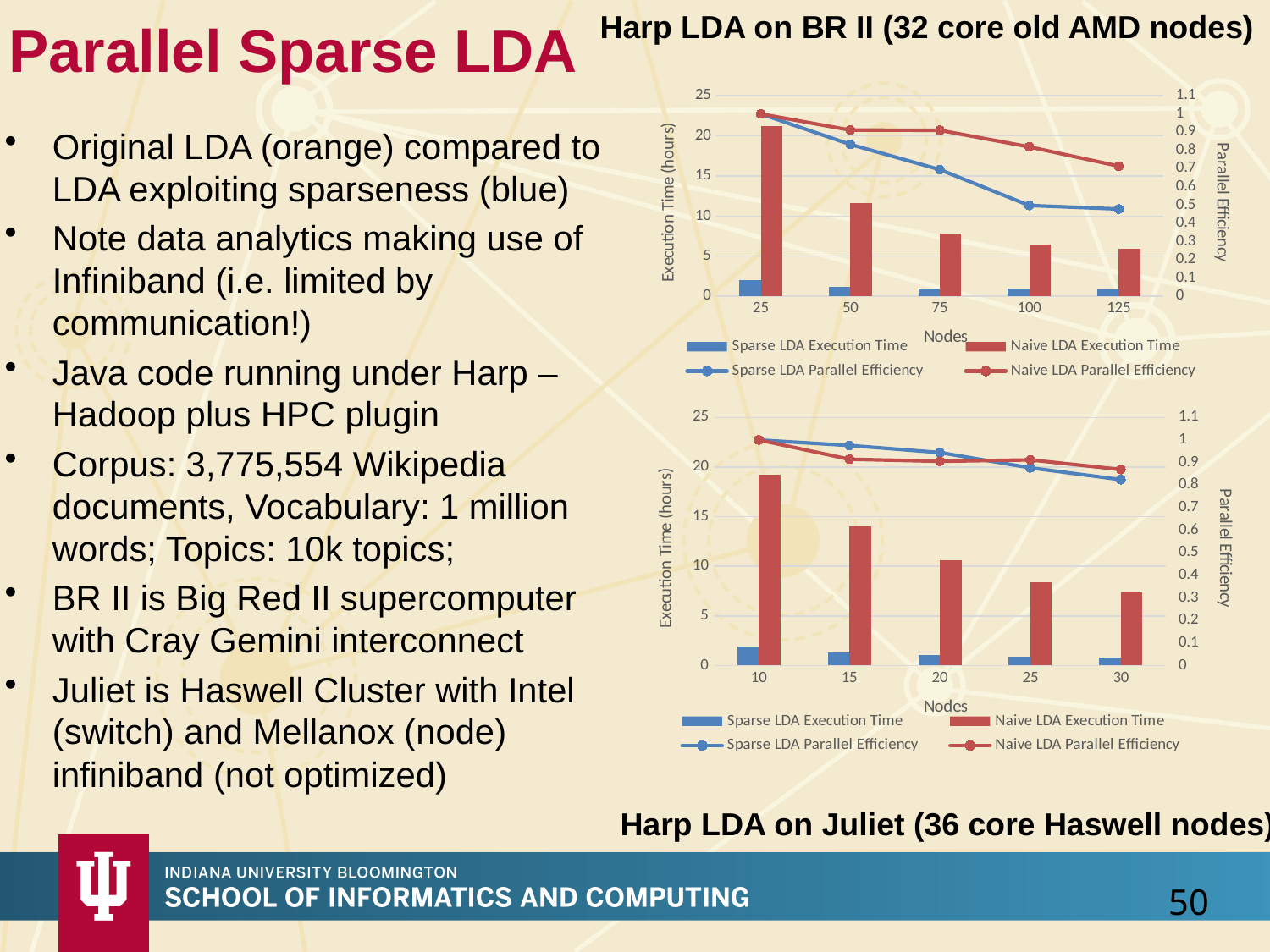
On the Harp LDA on BR II chart, how many node counts are shown on the x axis? 5 On the Harp LDA on Juliet chart, which is larger at 15 nodes, the Naive LDA Execution Time or the Sparse LDA Execution Time? Naive LDA Execution Time On the Harp LDA on BR II chart, at which node count is the Naive LDA Execution Time lowest? 125 On the Harp LDA on Juliet chart, is the Naive LDA Execution Time at 10 nodes greater or less than 15? greater On the Harp LDA on BR II chart, at which node count is the Naive LDA Execution Time highest? 25 On the Harp LDA on Juliet chart, how many series does the legend list? 4 On the Harp LDA on BR II chart, does the Sparse LDA Parallel Efficiency rise or fall as the number of nodes increases? fall On the Harp LDA on BR II chart, is the Sparse LDA Execution Time at 25 nodes greater or less than 5? less On the Harp LDA on Juliet chart, what is the label of the x axis? Nodes On the Harp LDA on BR II chart, is the Naive LDA Execution Time at 25 nodes greater or less than 20? greater On the Harp LDA on BR II chart, what kind of chart is used to show execution time? bar chart